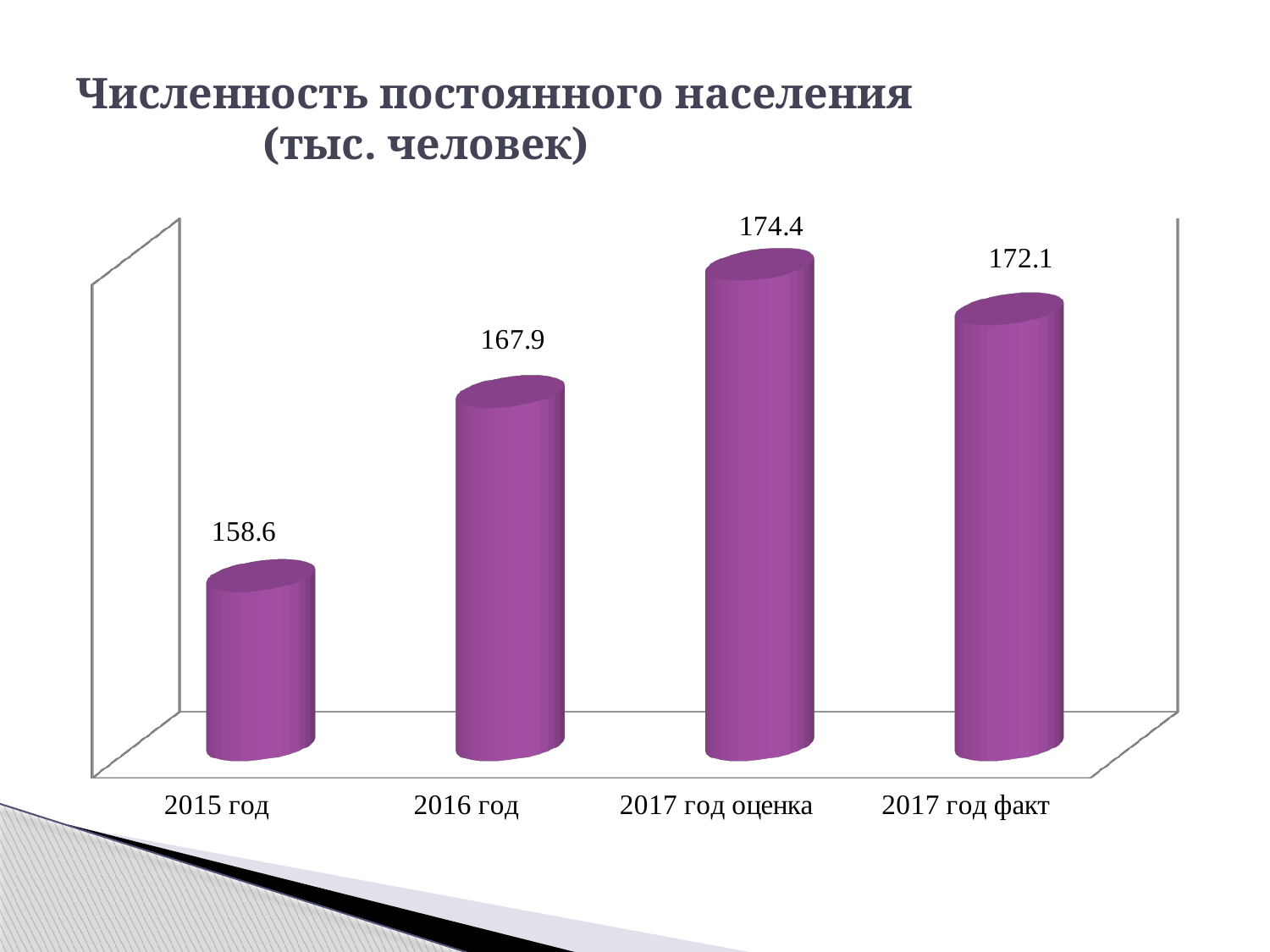
Which is larger, the value for 2016 год or the value for 2017 год факт? 2017 год факт What is the value for 2016 год? 167.9 Which category has the lowest value? 2015 год How many categories are shown on the chart? 4 What is the difference between the values for 2016 год and 2015 год? 9.3 What is the value for 2017 год факт? 172.1 What is the title of the chart? Численность постоянного населения (тыс. человек) What is the difference between the values for 2017 год оценка and 2017 год факт? 2.3 What kind of chart is this? bar chart What is the value for 2015 год? 158.6 What is the value for 2017 год оценка? 174.4 Which category has the highest value? 2017 год оценка